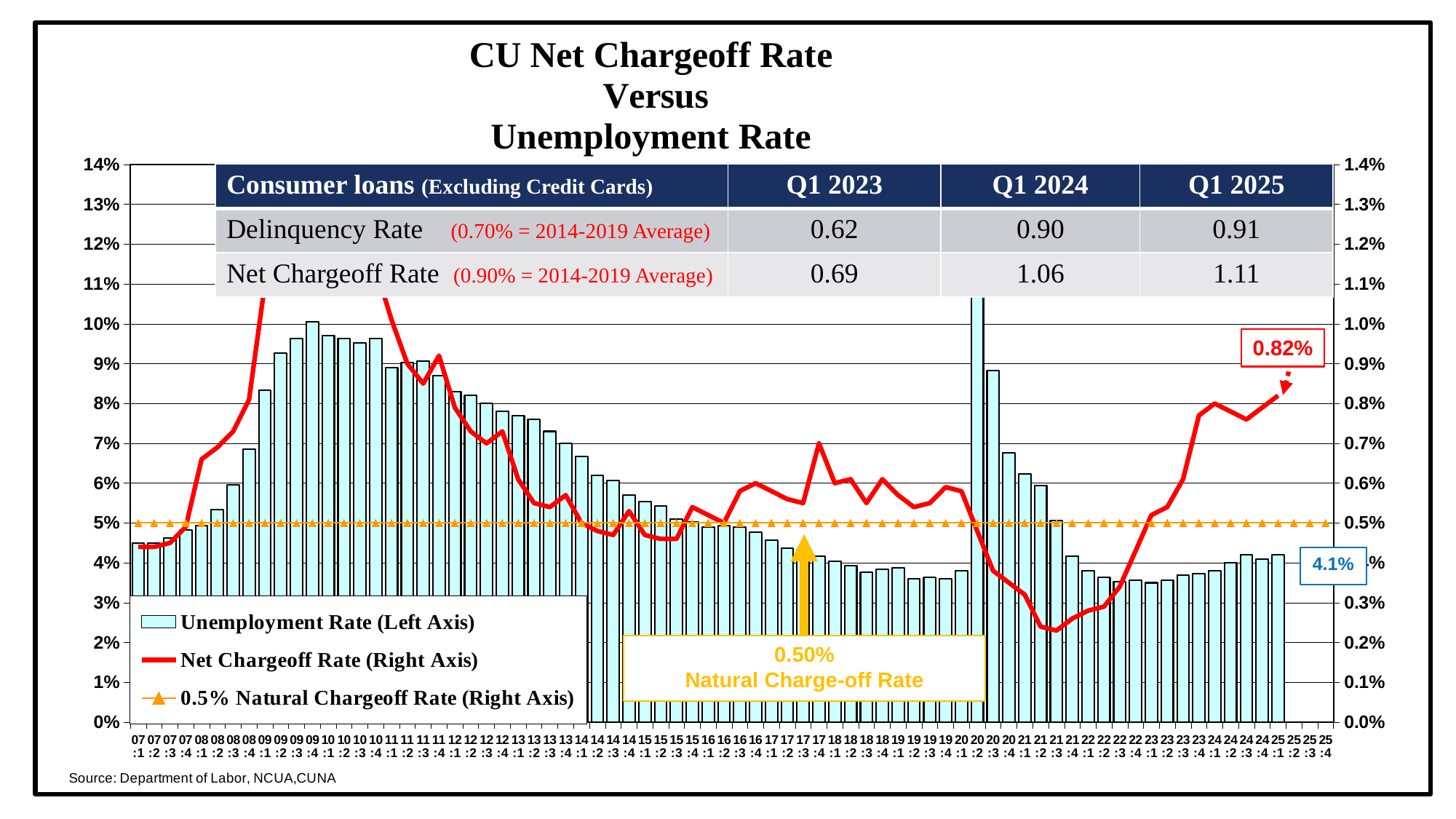
What kind of chart is this? Combination bar and line chart What is the labelled Unemployment Rate at the latest point (25:1)? 4.1% What is the labelled Net Chargeoff Rate at the latest point (25:1)? 0.82% What is the title of the chart? CU Net Chargeoff Rate Versus Unemployment Rate Is the Net Chargeoff Rate at 21:2 greater or less than 0.3%? less What value is the Natural Charge-off Rate line set at? 0.50% In the table, what is the difference between the Net Chargeoff Rate in Q1 2025 and Q1 2023? 0.42 In the table, what is the Net Chargeoff Rate for consumer loans in Q1 2025? 1.11 Is the Unemployment Rate bar for 09:4 greater or less than 9%? greater How many series does the chart legend list? 3 Which quarter has the highest Unemployment Rate bar? 20:2 Does the Unemployment Rate rise or fall from 09:4 to 19:4? fall